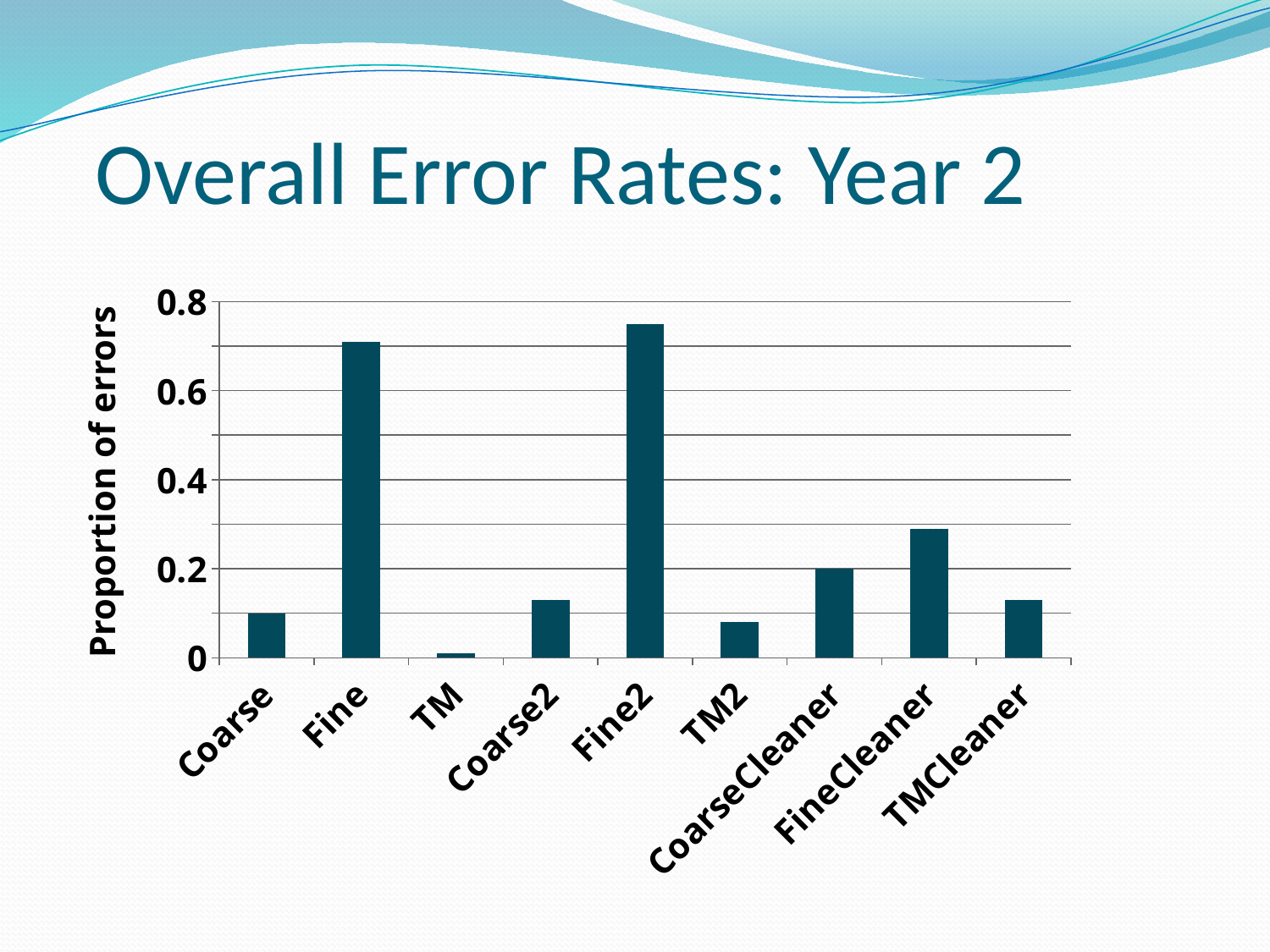
Is the value for Fine2 greater or less than 0.6? greater Is the value for Fine greater or less than 0.6? greater Is the value for FineCleaner greater or less than 0.2? greater Which has a higher proportion of errors, Fine or Fine2? Fine2 Which category has the highest proportion of errors? Fine2 What is the label on the vertical axis of the chart? Proportion of errors Which has a higher proportion of errors, CoarseCleaner or FineCleaner? FineCleaner How many categories are shown on the x axis of the chart? 9 What kind of chart is shown on the slide? bar chart Which category has the lowest proportion of errors? TM